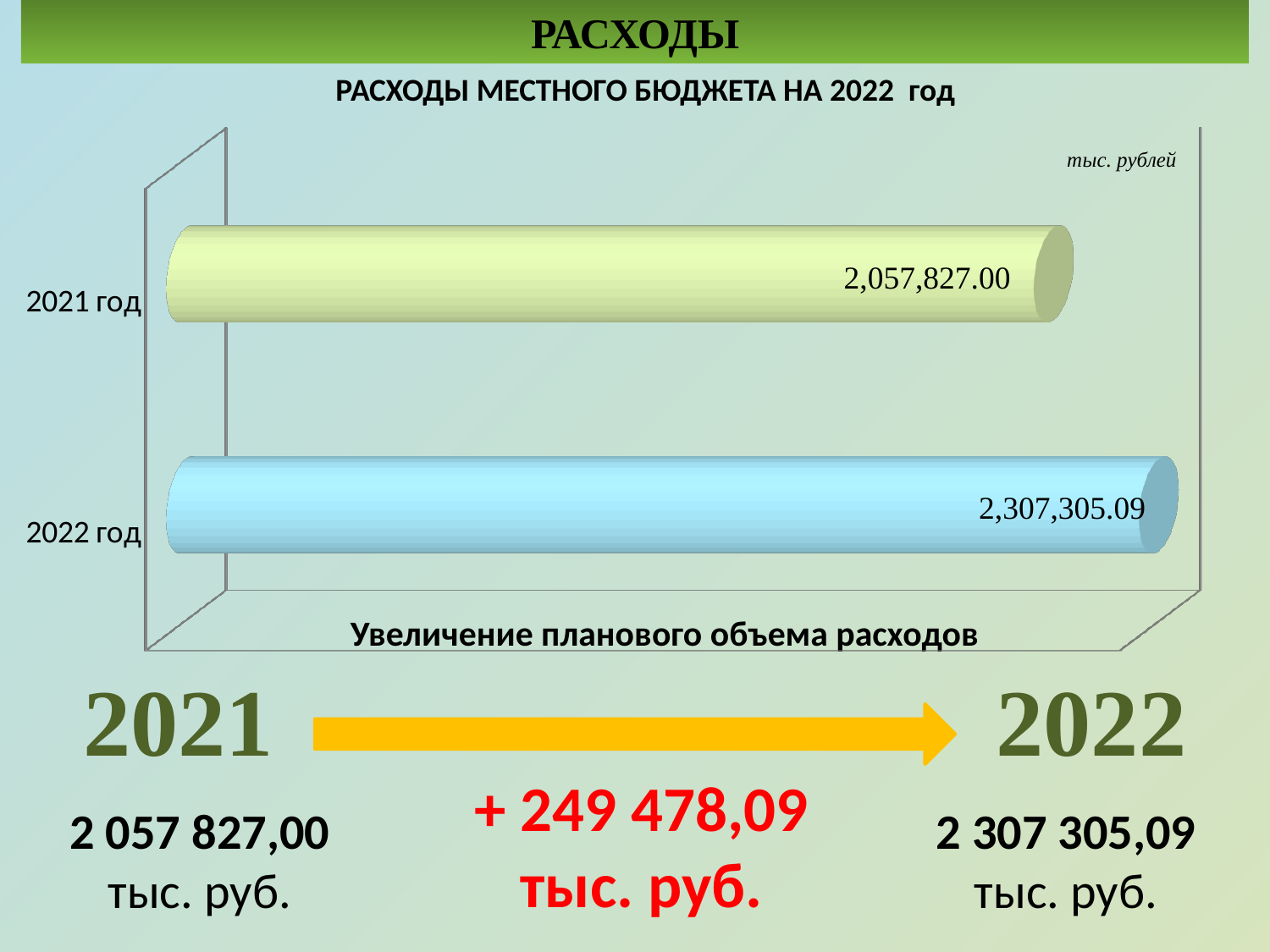
What is the title of the chart? РАСХОДЫ МЕСТНОГО БЮДЖЕТА НА 2022 год Which year has the higher expenditure value? 2022 год What is the difference between the 2022 год and 2021 год values? 249,478.09 What kind of chart is shown on the slide? bar chart What is the value for 2021 год? 2,057,827.00 What is the value for 2022 год? 2,307,305.09 How many categories (years) are plotted in the chart? 2 Is the value for 2022 год larger or smaller than the value for 2021 год? larger What unit is indicated for the chart values? тыс. рублей Which year has the lower expenditure value? 2021 год